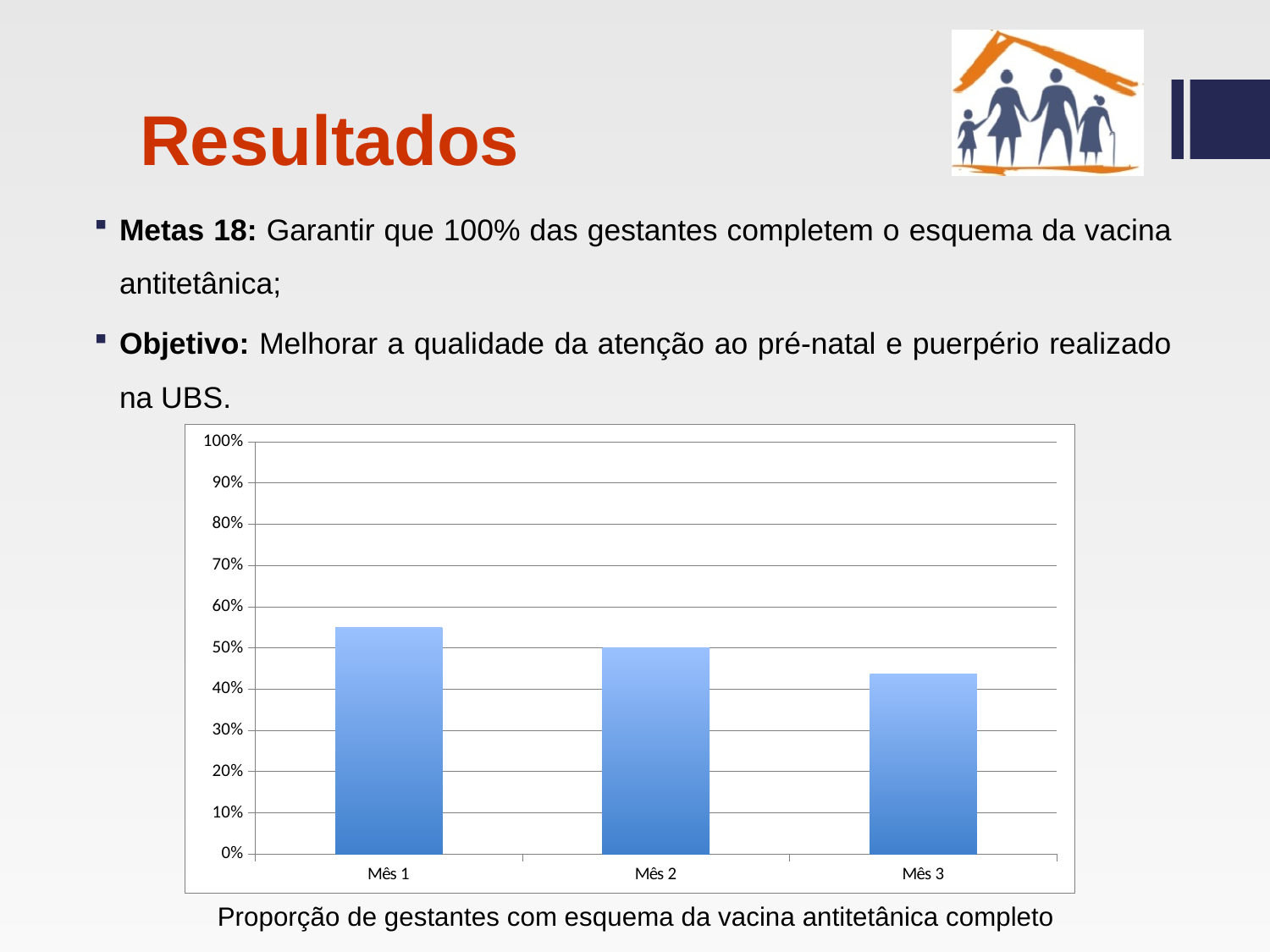
Is the value for Mês 1 greater or less than 50%? greater Is the value for Mês 3 greater or less than 50%? less Is the value for Mês 3 greater or less than 40%? greater Which is larger, the value for Mês 1 or the value for Mês 3? Mês 1 Do the values rise or fall from Mês 1 to Mês 3? fall Which month has the highest bar in the chart? Mês 1 What is the highest value shown on the vertical axis of the chart? 100% What kind of chart is shown on the slide? bar chart What is the value for Mês 2 in the chart? 50% Which month has the lowest bar in the chart? Mês 3 How many months (categories) are plotted in the chart? 3